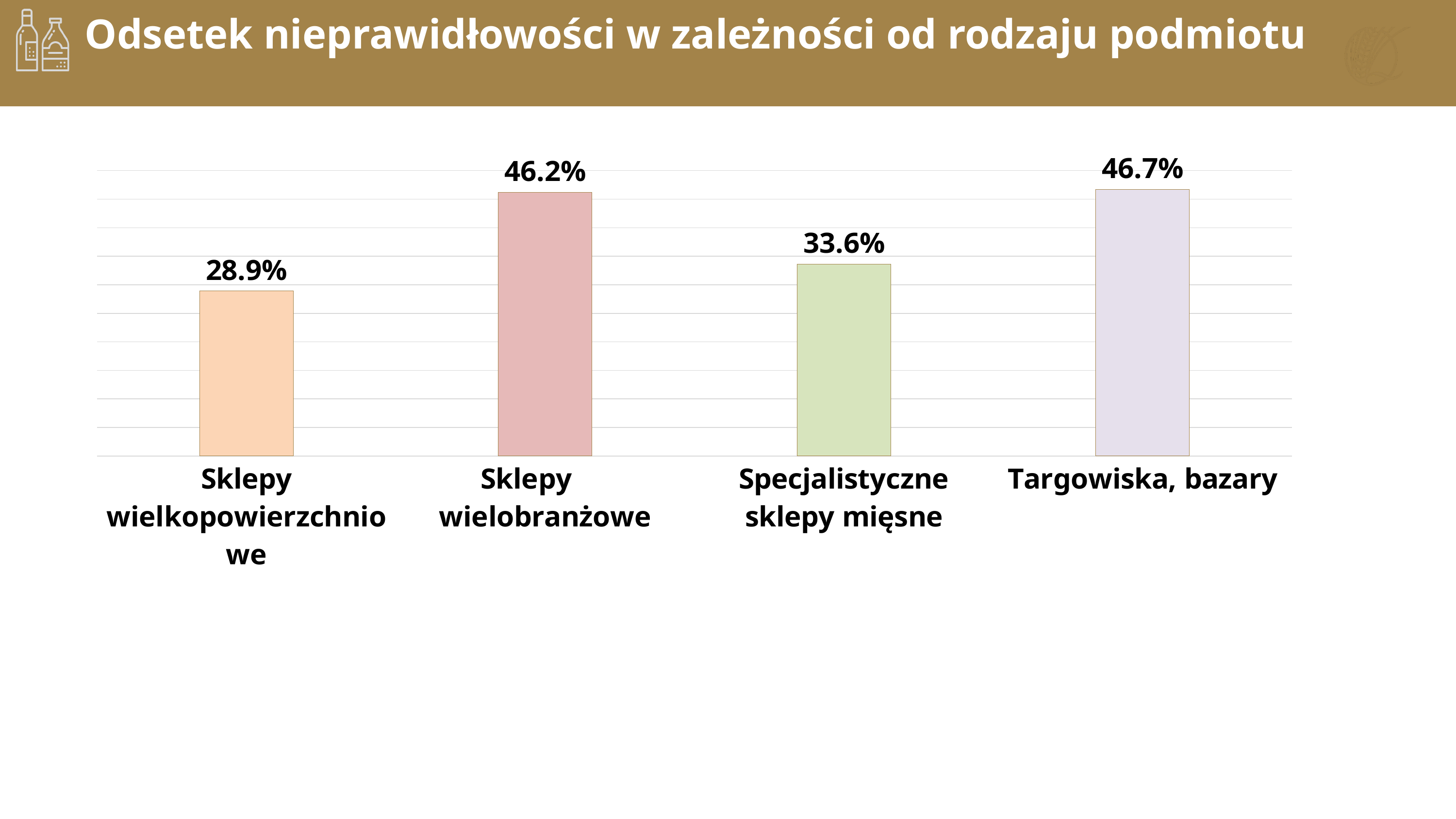
How many categories are shown in the chart? 4 What is the value for Specjalistyczne sklepy mięsne? 33.6% What is the difference between the values for Targowiska, bazary and Specjalistyczne sklepy mięsne? 13.1 percentage points What kind of chart is shown on the slide? Bar chart Which category has the lowest value? Sklepy wielkopowierzchniowe What is the value for Sklepy wielobranżowe? 46.2% What is the value for Sklepy wielkopowierzchniowe? 28.9% What is the title of the slide? Odsetek nieprawidłowości w zależności od rodzaju podmiotu What is the difference between the values for Sklepy wielobranżowe and Sklepy wielkopowierzchniowe? 17.3 percentage points What is the value for Targowiska, bazary? 46.7% Which category has the highest value? Targowiska, bazary Which is larger, the value for Specjalistyczne sklepy mięsne or the value for Sklepy wielkopowierzchniowe? Specjalistyczne sklepy mięsne